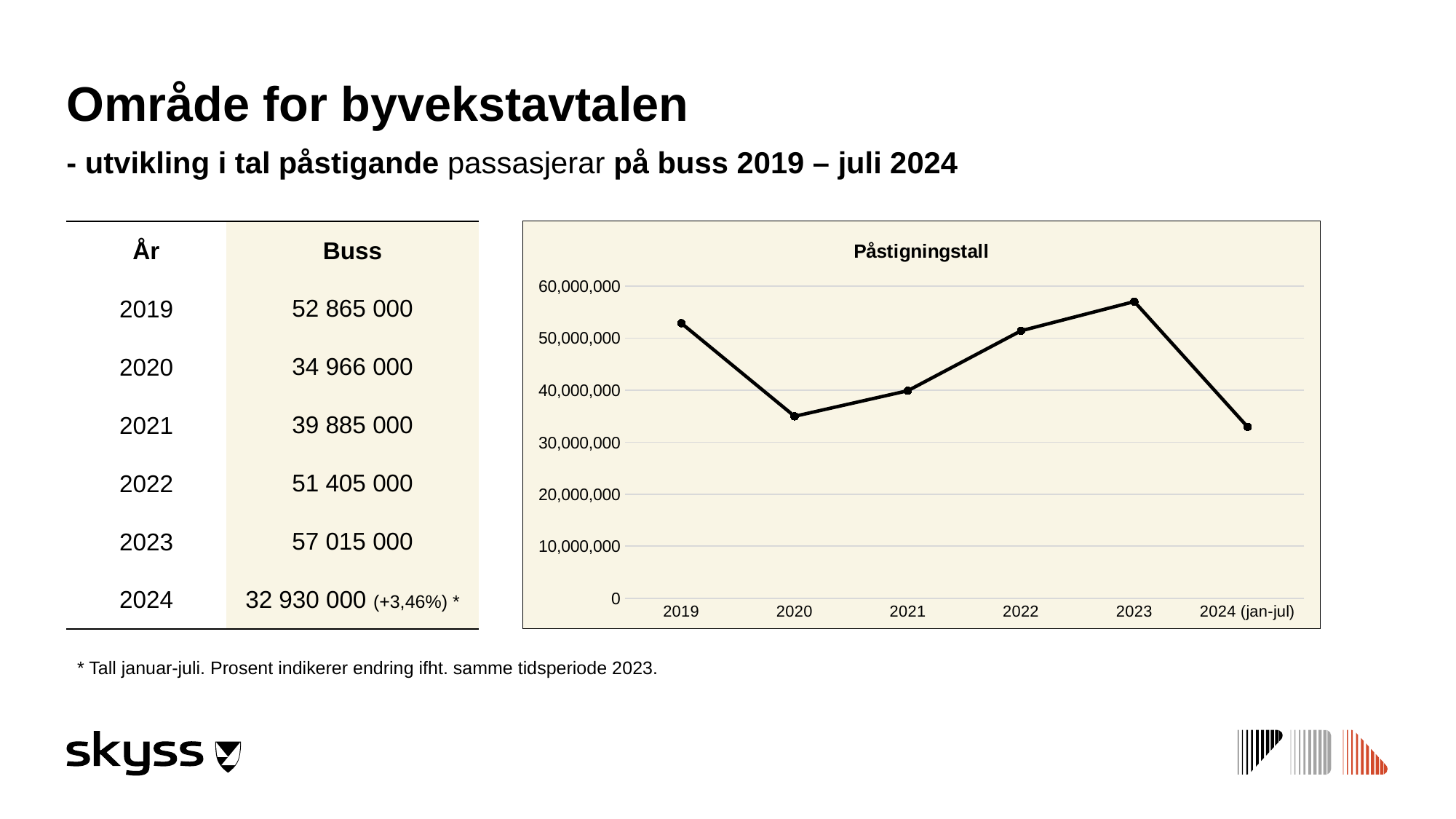
Which year has the highest value on the "Påstigningstall" chart? 2023 How many data points are plotted on the "Påstigningstall" line chart? 6 What is the title of the line chart on the slide? Påstigningstall Is the value for 2020 on the "Påstigningstall" chart greater or less than 40,000,000? less Is the value for 2023 on the "Påstigningstall" chart greater or less than 50,000,000? greater Do the values on the "Påstigningstall" chart rise or fall from 2020 to 2023? rise Is the value for 2024 (jan-jul) on the "Påstigningstall" chart greater or less than 30,000,000? greater Which is larger on the "Påstigningstall" chart, the value for 2019 or the value for 2021? 2019 According to the table, what is the difference between the Buss values for 2023 and 2019? 4 150 000 What kind of chart is the "Påstigningstall" chart? line chart Which point has the lowest value on the "Påstigningstall" chart? 2024 (jan-jul) According to the table, what is the Buss value for 2023? 57 015 000